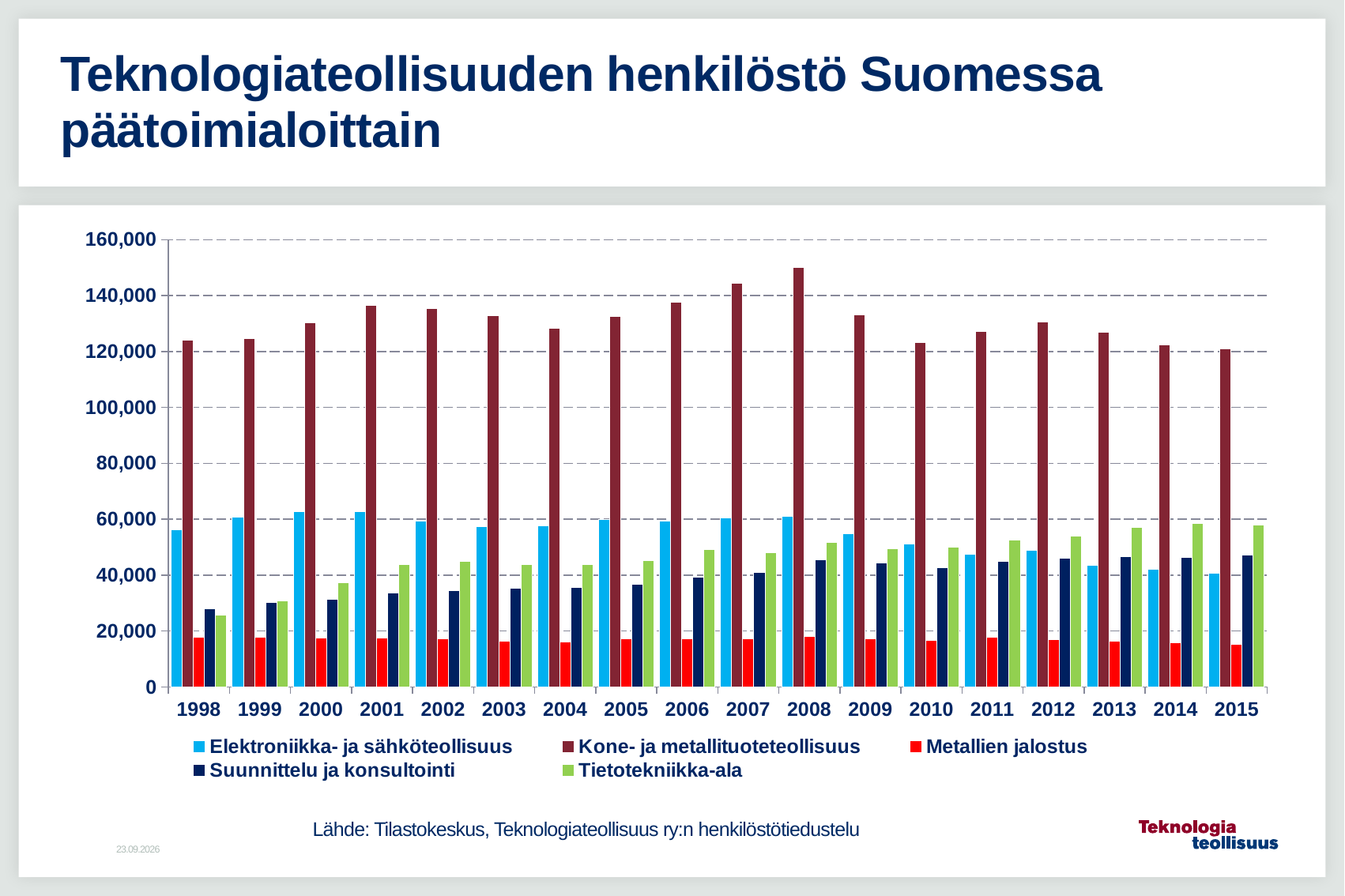
Which is larger in 1998: Elektroniikka- ja sähköteollisuus or Tietotekniikka-ala? Elektroniikka- ja sähköteollisuus How many years are shown on the x axis? 18 Does the value for Tietotekniikka-ala generally rise or fall from 1998 to 2015? Rise How many series does the legend list? 5 What kind of chart is shown on the slide? Bar chart In which year is the value for Kone- ja metallituoteteollisuus highest? 2008 Which is larger in 2015: Tietotekniikka-ala or Elektroniikka- ja sähköteollisuus? Tietotekniikka-ala Is the value for Metallien jalostus in 2008 greater or less than 20,000? less Is the value for Elektroniikka- ja sähköteollisuus in 1998 greater or less than 60,000? less In which year is the value for Tietotekniikka-ala lowest? 1998 In which year is the value for Suunnittelu ja konsultointi lowest? 1998 Is the value for Kone- ja metallituoteteollisuus in 2008 greater or less than 140,000? greater